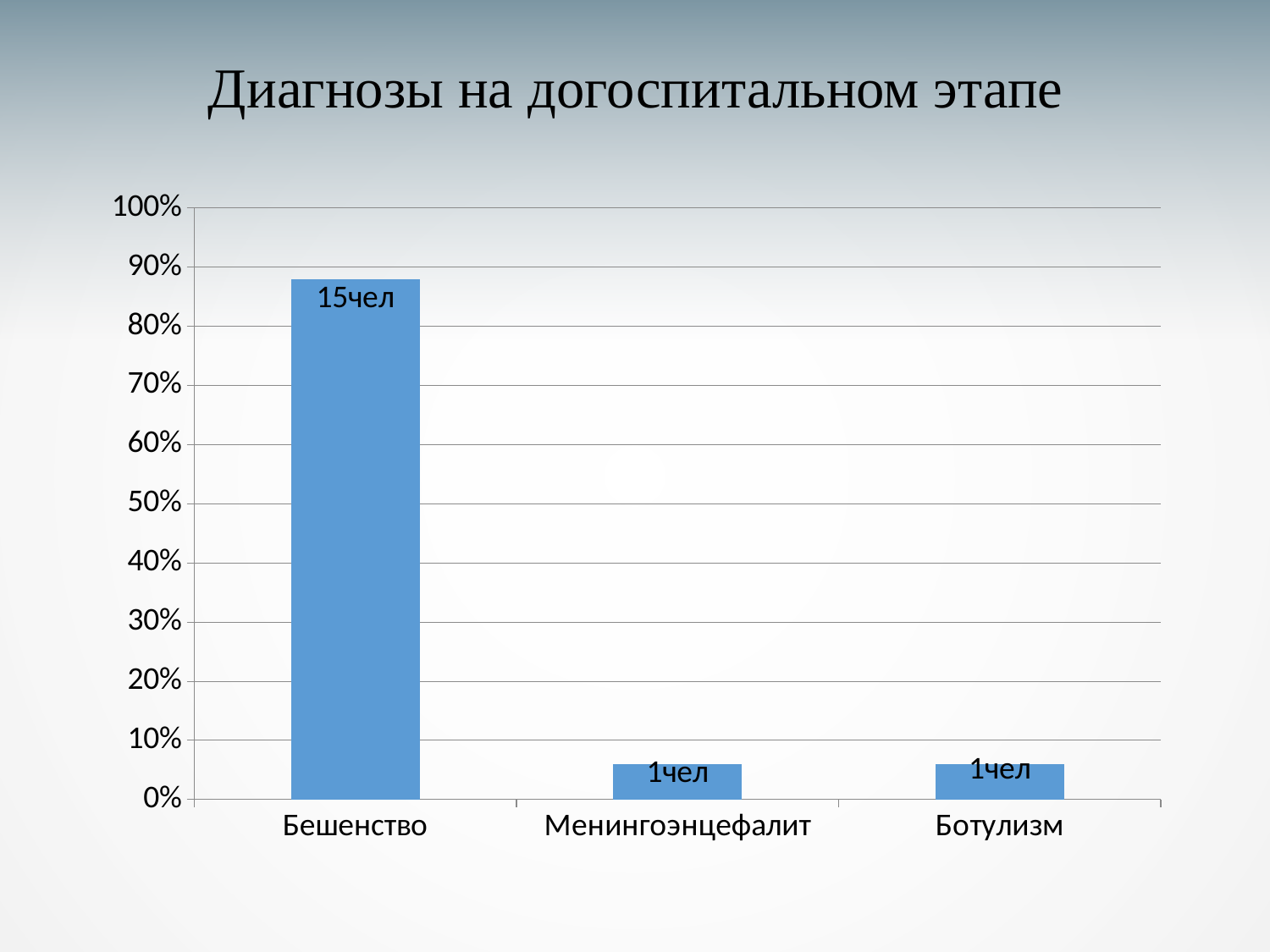
What is the data label on the bar for Бешенство? 15чел Is the value for Бешенство greater or less than 80%? greater Which category has the highest bar? Бешенство What is the data label on the bar for Ботулизм? 1чел Is the value for Ботулизм greater or less than 20%? less Which is larger, the value for Бешенство or the value for Ботулизм? Бешенство How many categories are shown on the x axis? 3 What kind of chart is shown on the slide? Bar chart What is the title of the slide? Диагнозы на догоспитальном этапе By how many people does the Бешенство bar exceed the Менингоэнцефалит bar, according to the data labels? 14чел What is the data label on the bar for Менингоэнцефалит? 1чел Is the value for Менингоэнцефалит greater or less than 10%? less